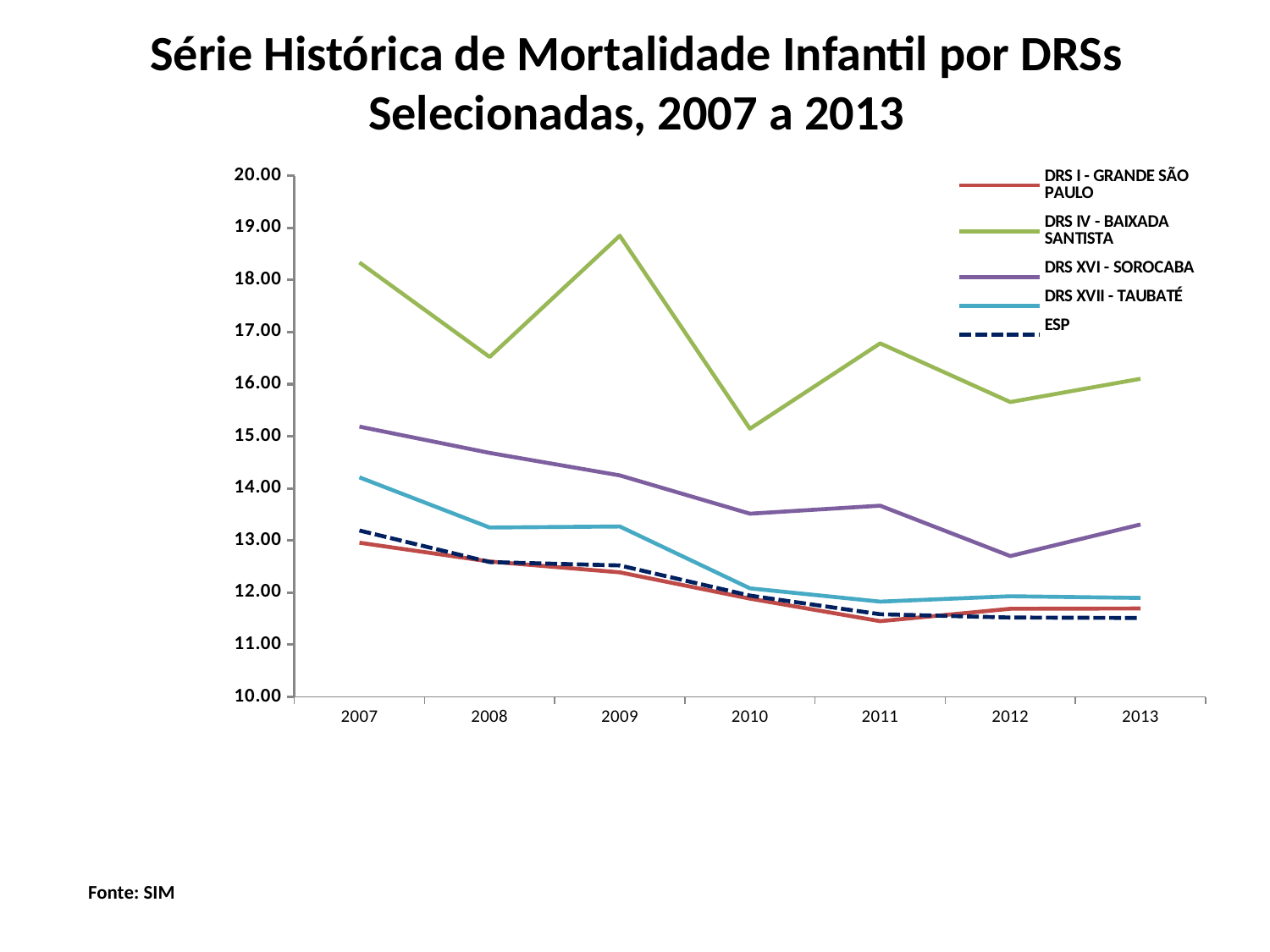
Is the value for DRS XVII - TAUBATÉ in 2007 greater or less than 14.00? greater What kind of chart is shown on the slide? line chart In which year does DRS XVI - SOROCABA reach its lowest value? 2012 How many years are plotted along the x axis? 7 Does the DRS XVII - TAUBATÉ line generally rise or fall from 2007 to 2013? fall In 2011, which is larger: DRS XVI - SOROCABA or DRS XVII - TAUBATÉ? DRS XVI - SOROCABA Which series has the highest value in 2009? DRS IV - BAIXADA SANTISTA In which year does DRS IV - BAIXADA SANTISTA reach its highest value? 2009 Is the value for DRS XVI - SOROCABA in 2012 greater or less than 13.00? less Is the value for DRS IV - BAIXADA SANTISTA in 2009 greater or less than 18.00? greater How many series does the legend list? 5 In which year does DRS IV - BAIXADA SANTISTA reach its lowest value? 2010